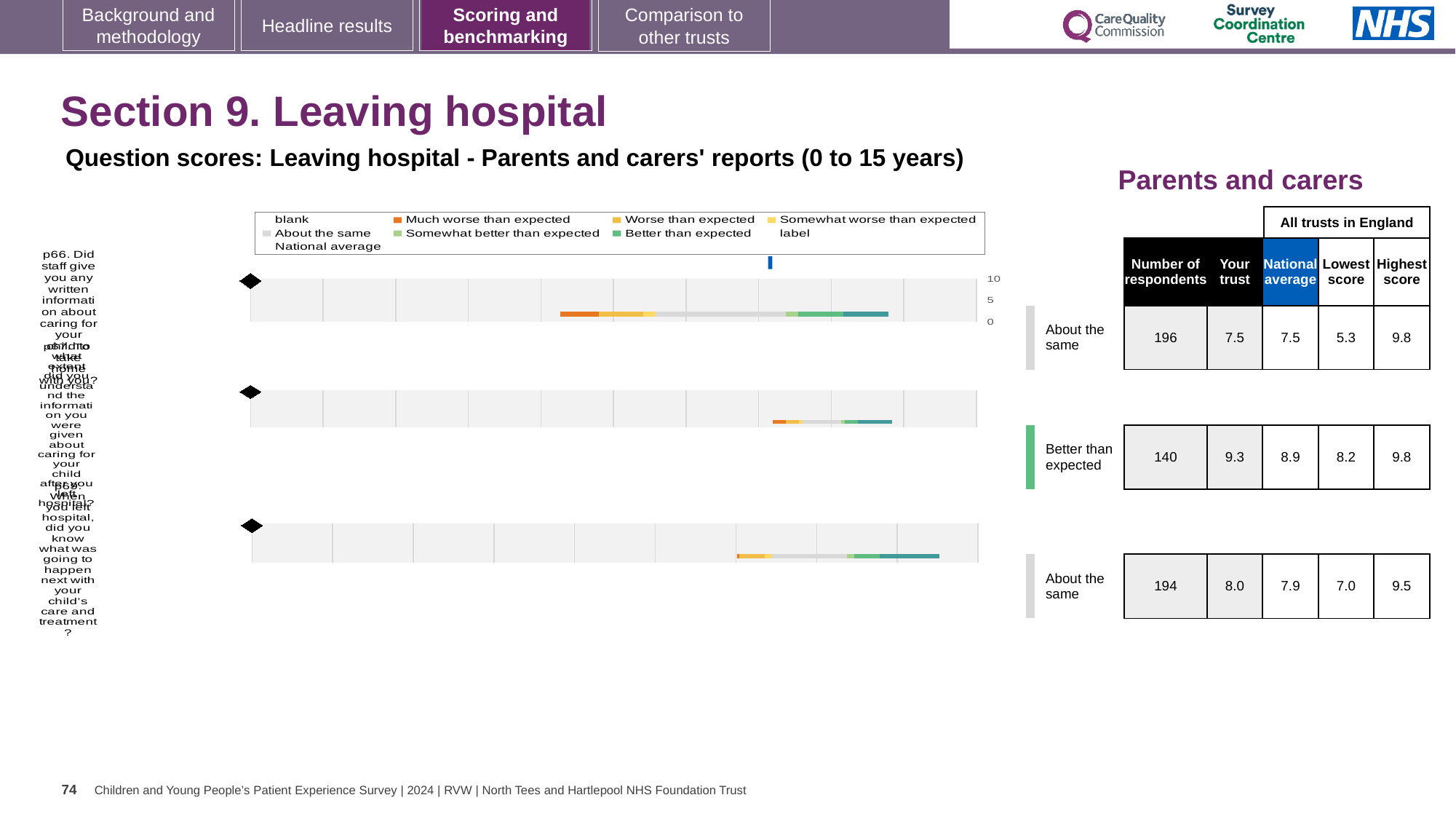
Which of the three charts has the lowest 'Your trust' score? the top chart (7.5) For the top chart (p66, written information about caring for your child at home), what is the 'Your trust' score in the table? 7.5 What is the difference between the 'Your trust' score and the national average for the middle chart? 0.4 What benchmark category is the middle chart rated as? Better than expected For the middle chart, what is the 'Your trust' score in the table? 9.3 For the bottom chart (p68, did you know what was going to happen next), what is the national average score? 7.9 Is the 'Your trust' score for the middle chart larger than the national average for that chart? Yes, 9.3 vs 8.9 Which legend entry is shown with a dark orange colour? Much worse than expected What kind of chart is used to show the question scores on this slide? bar chart Which of the three charts has the highest 'Your trust' score? the middle chart (9.3) How many question score charts (bar rows) are shown on the slide? 3 What is the highest tick value shown on the axis above the top chart? 10